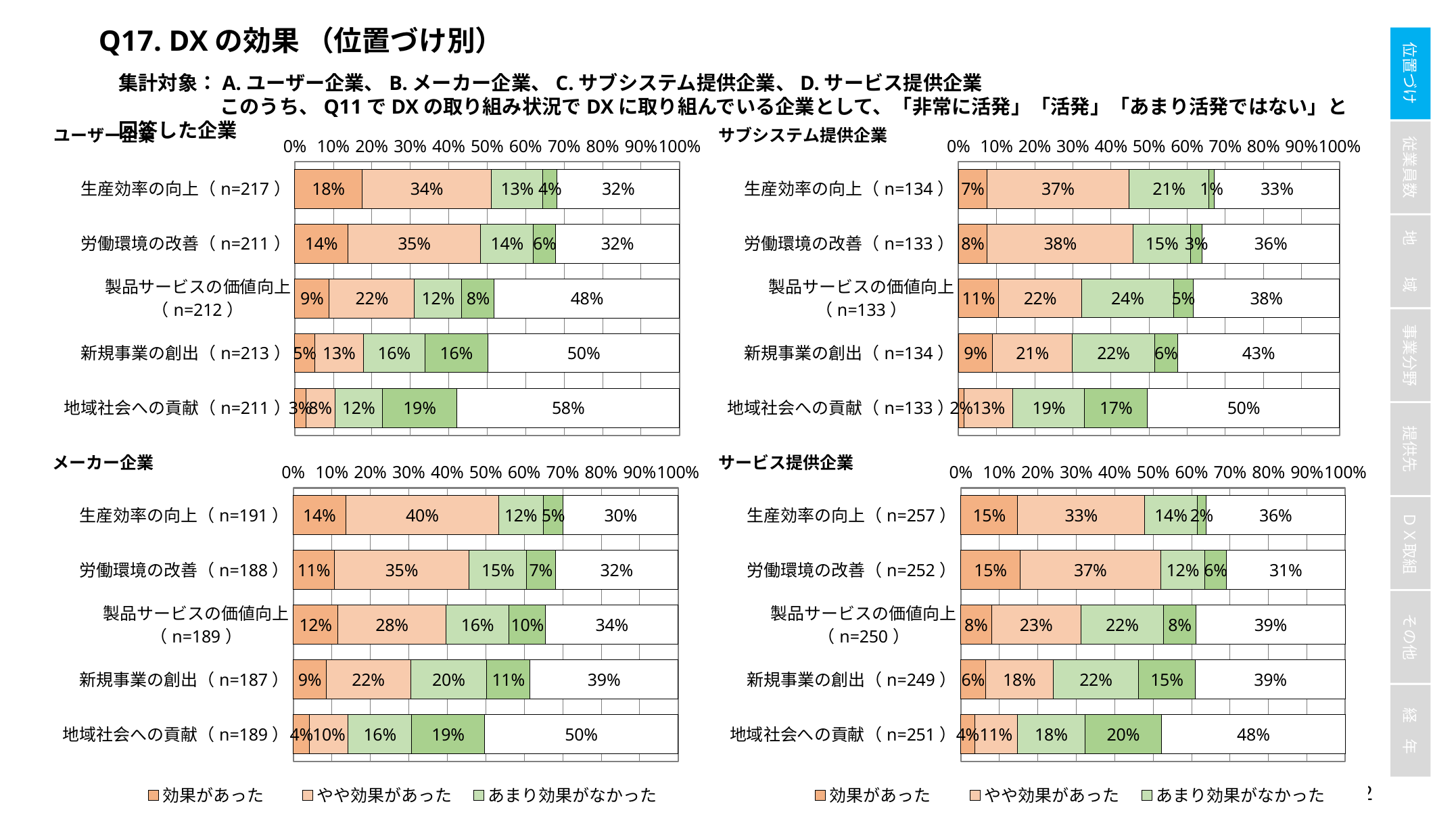
In the ユーザー企業 chart, which category has the highest 効果があった value? 生産効率の向上 In the サービス提供企業 chart, what is the difference between the やや効果があった values for 労働環境の改善 and 生産効率の向上? 4 percentage points What kind of chart is the ユーザー企業 chart? Stacked bar chart In the サービス提供企業 chart, what is the n value shown for 生産効率の向上? 257 In the サブシステム提供企業 chart, what is the あまり効果がなかった value for 製品サービスの価値向上? 24% In the メーカー企業 chart, what is the あまり効果がなかった value for 新規事業の創出? 20% In the メーカー企業 chart, what is the やや効果があった value for 生産効率の向上? 40% In the ユーザー企業 chart, what is the 効果があった value for 生産効率の向上? 18% In the メーカー企業 chart, which category has the lowest 効果があった value? 地域社会への貢献 In the サブシステム提供企業 chart, which has the larger 効果があった value: 製品サービスの価値向上 or 新規事業の創出? 製品サービスの価値向上 How many categories are shown in the サービス提供企業 chart? 5 In the サービス提供企業 chart, what is the 効果があった value for 労働環境の改善? 15%